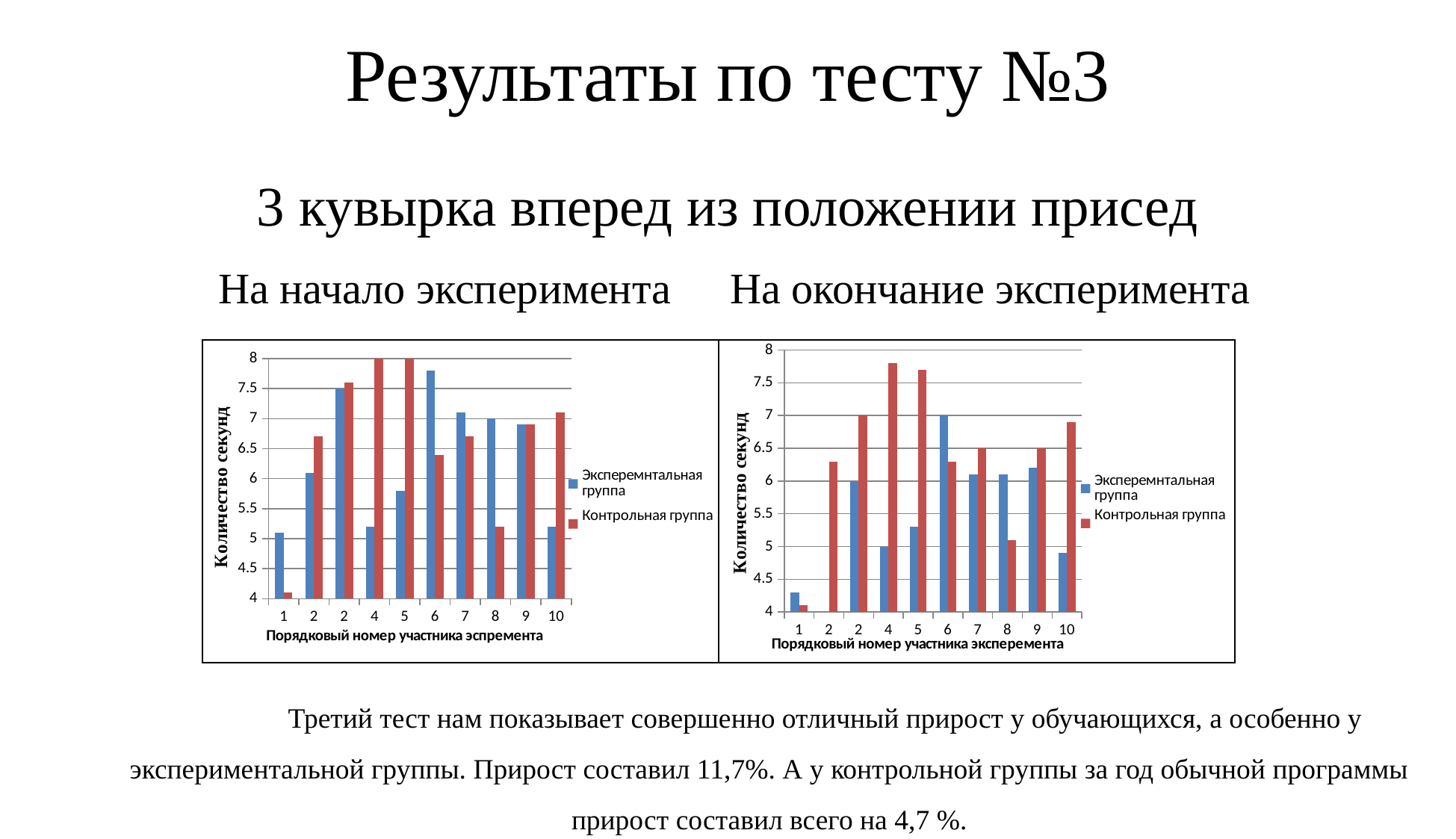
In the 'На окончание эксперимента' chart, is the Контрольная группа value for participant 8 greater or less than 5.5? less What is the y-axis title of the 'На окончание эксперимента' chart? Количество секунд What kind of chart is shown under 'На начало эксперимента'? Bar chart In the 'На начало эксперимента' chart, which participant has the highest Эксперемнтальная группа value? 6 How many participants are plotted along the x axis of the 'На начало эксперимента' chart? 10 How many series does the legend of the 'На окончание эксперимента' chart list? 2 In the 'На начало эксперимента' chart, which series has the larger value for participant 4? Контрольная группа In the 'На начало эксперимента' chart, is the Эксперемнтальная группа value for participant 6 greater or less than 7.5? greater In the 'На окончание эксперимента' chart, which series has the larger value for participant 10? Контрольная группа In the 'На окончание эксперимента' chart, what is the value for participant 6 in the Эксперемнтальная группа series? 7